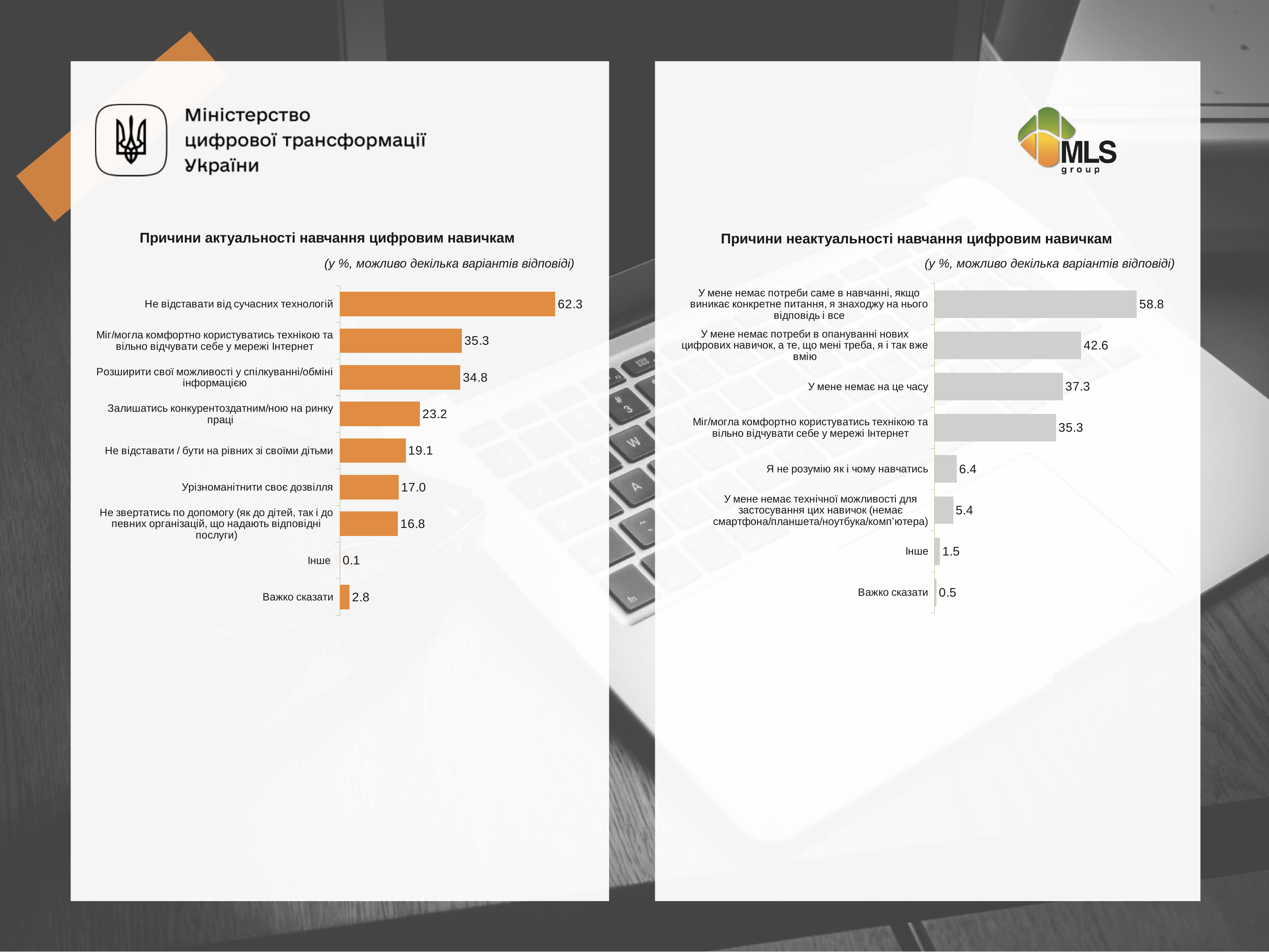
In the chart 'Причини неактуальності навчання цифровим навичкам', how many categories are shown? 8 In the chart 'Причини актуальності навчання цифровим навичкам', which category has the lowest value? Інше In the chart 'Причини актуальності навчання цифровим навичкам', what is the difference between 'Міг/могла комфортно користуватись технікою та вільно відчувати себе у мережі Інтернет' and 'Залишатись конкурентоздатним/ною на ринку праці'? 12.1 In the chart 'Причини актуальності навчання цифровим навичкам', what is the value for 'Не відставати від сучасних технологій'? 62.3 In the chart 'Причини актуальності навчання цифровим навичкам', what is the value for 'Урізноманітнити своє дозвілля'? 17.0 In the chart 'Причини неактуальності навчання цифровим навичкам', which is larger: 'Я не розумію як і чому навчатись' or 'У мене немає технічної можливості для застосування цих навичок'? Я не розумію як і чому навчатись What colour are the bars in the chart 'Причини неактуальності навчання цифровим навичкам'? Grey In the chart 'Причини неактуальності навчання цифровим навичкам', what is the value for 'У мене немає на це часу'? 37.3 In the chart 'Причини неактуальності навчання цифровим навичкам', what is the difference between the two highest values, 58.8 and 42.6? 16.2 What type of chart is 'Причини актуальності навчання цифровим навичкам'? Bar chart In the chart 'Причини актуальності навчання цифровим навичкам', how many categories are shown? 9 In the chart 'Причини неактуальності навчання цифровим навичкам', which category has the highest value? У мене немає потреби саме в навчанні, якщо виникає конкретне питання, я знаходжу на нього відповідь і все